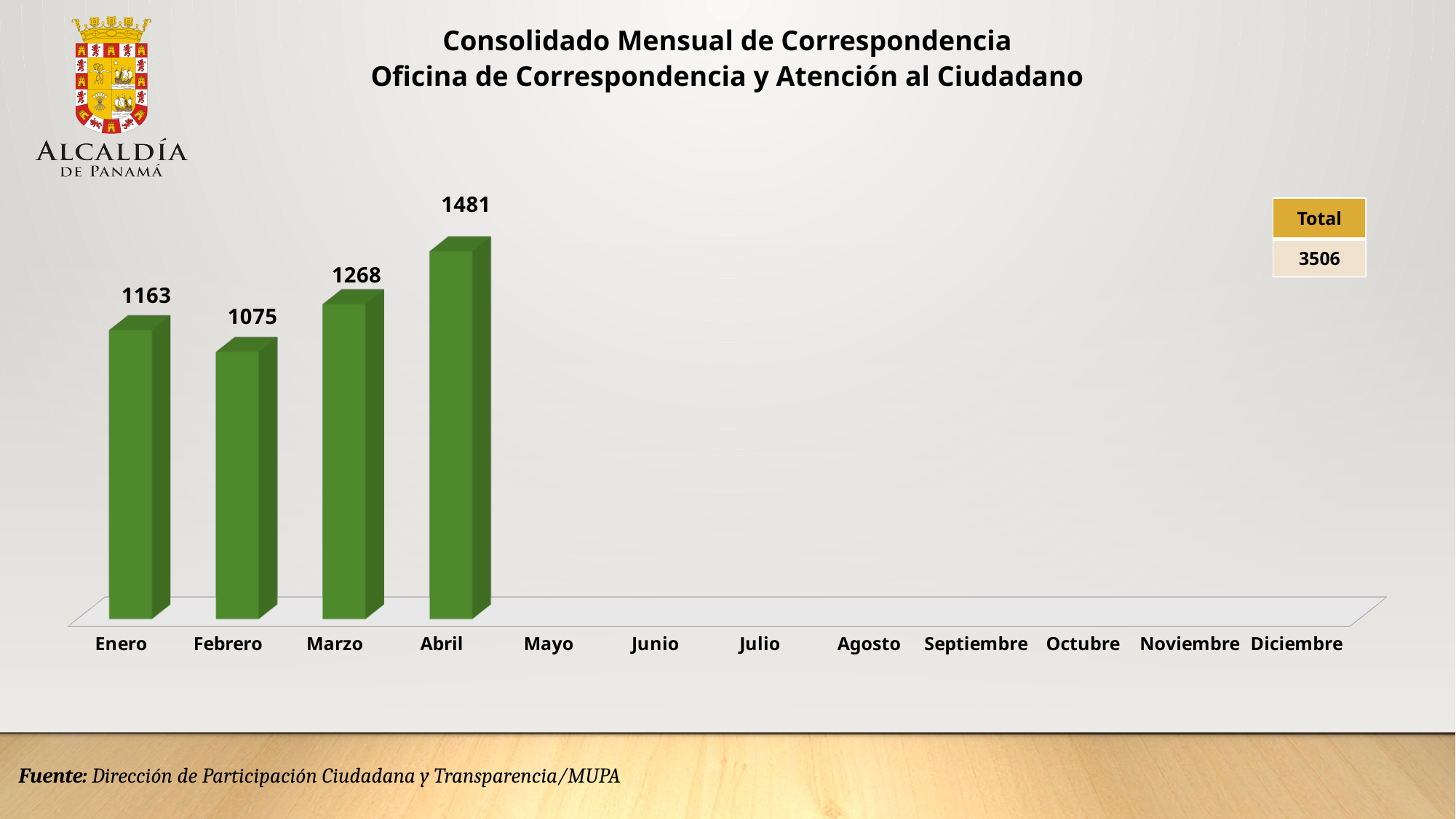
What is the value for Marzo? 1268 What is the value for Abril? 1481 What is the value for Febrero? 1075 What is the difference between the values for Abril and Marzo? 213 What value is shown in the Total box on the right of the chart? 3506 What kind of chart is shown on the slide? Bar chart What is the value for Enero? 1163 Which is larger, the value for Enero or the value for Febrero? Enero How many month categories are listed along the x axis? 12 How many months have a bar plotted on the chart? 4 Which month has the highest value? Abril Which month with a plotted bar has the lowest value? Febrero